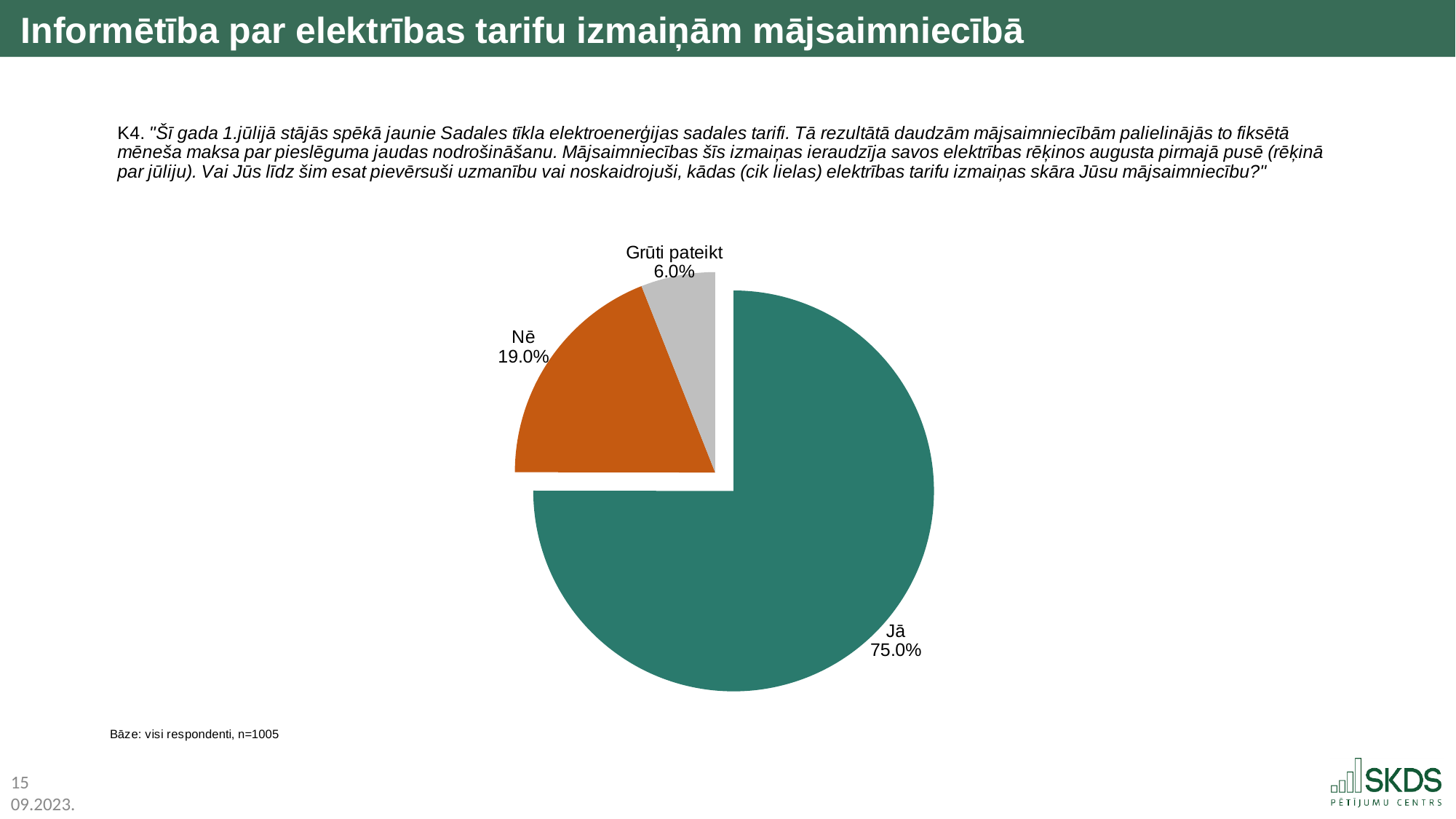
What percentage of respondents answered "Grūti pateikt"? 6.0% Which is larger, the share for "Nē" or the share for "Grūti pateikt"? Nē What percentage of respondents answered "Nē"? 19.0% Which answer category has the largest share of the pie? Jā What is the difference in percentage points between "Nē" and "Grūti pateikt"? 13.0 What colour is the "Jā" slice of the pie? teal green What is the difference in percentage points between "Jā" and "Nē"? 56.0 What percentage of respondents answered "Jā"? 75.0% What type of chart is shown on the slide? pie chart What is the base (number of respondents) stated below the chart? n=1005 How many slices does the pie chart have? 3 Which answer category has the smallest share of the pie? Grūti pateikt